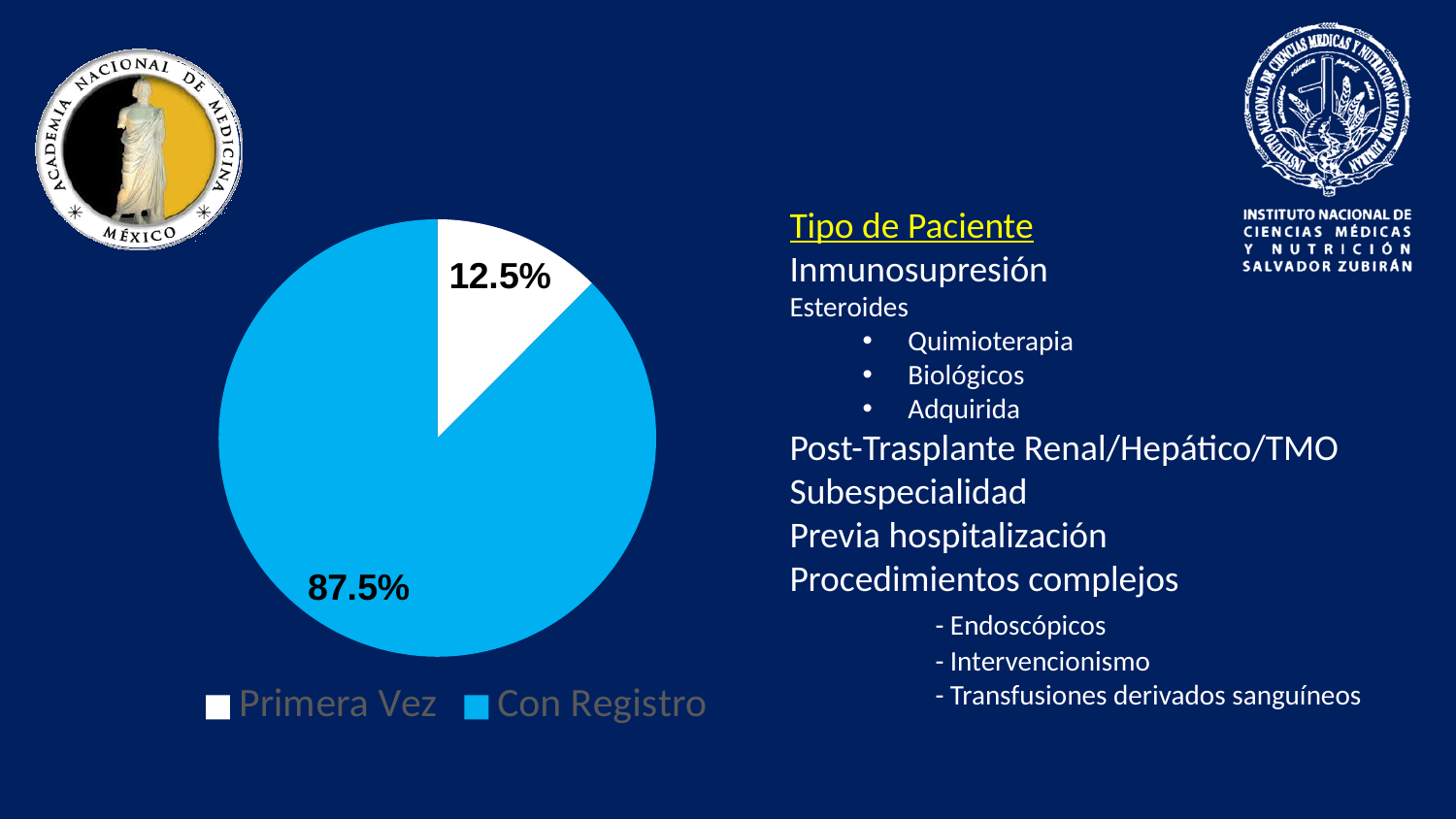
What kind of chart is shown on the slide? pie chart What colour is the Con Registro slice? light blue What is the value for Primera Vez? 12.5% What is the difference between the Con Registro and Primera Vez values? 75% What is the value for Con Registro? 87.5% How many entries does the legend list? 2 Which is larger, Primera Vez or Con Registro? Con Registro What share of the pie does Con Registro represent? 87.5% Which category has the smallest slice of the pie? Primera Vez Which category has the largest slice of the pie? Con Registro What colour is the Primera Vez slice? white How many slices does the pie chart have? 2